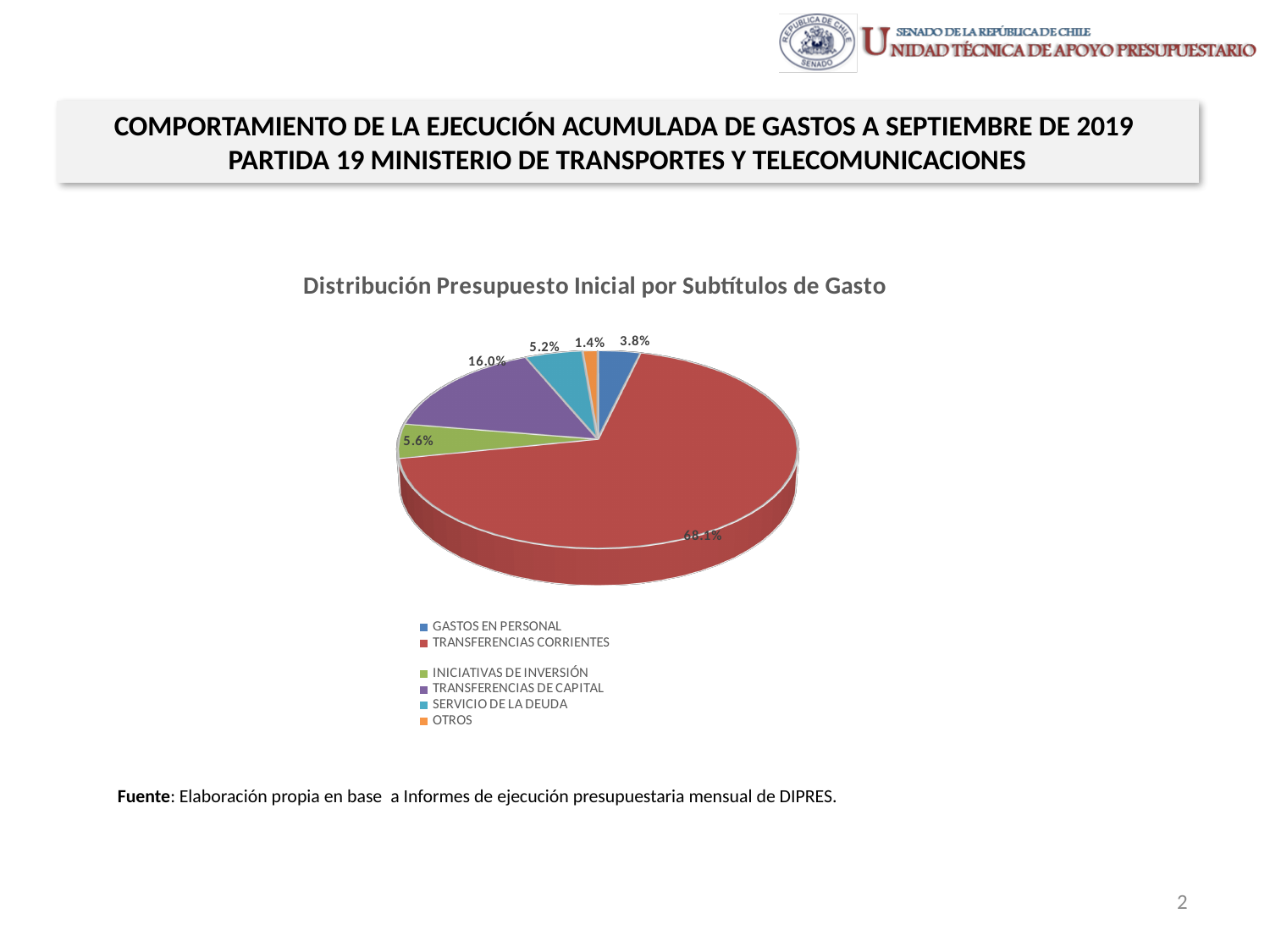
What is the value shown for SERVICIO DE LA DEUDA? 5.2% Which category has the largest slice of the pie? TRANSFERENCIAS CORRIENTES What is the difference in percentage points between TRANSFERENCIAS DE CAPITAL and INICIATIVAS DE INVERSIÓN? 10.4 percentage points Which is larger, INICIATIVAS DE INVERSIÓN or GASTOS EN PERSONAL? INICIATIVAS DE INVERSIÓN How many categories does the legend of the pie chart list? 6 What share of the pie does TRANSFERENCIAS DE CAPITAL represent? 16.0% Which category has the smallest slice of the pie? OTROS What is the value shown for GASTOS EN PERSONAL? 3.8% What is the value shown for OTROS? 1.4% What share of the pie does TRANSFERENCIAS CORRIENTES represent? 68.1% What is the title of the chart? Distribución Presupuesto Inicial por Subtítulos de Gasto What kind of chart is shown on the slide? Pie chart